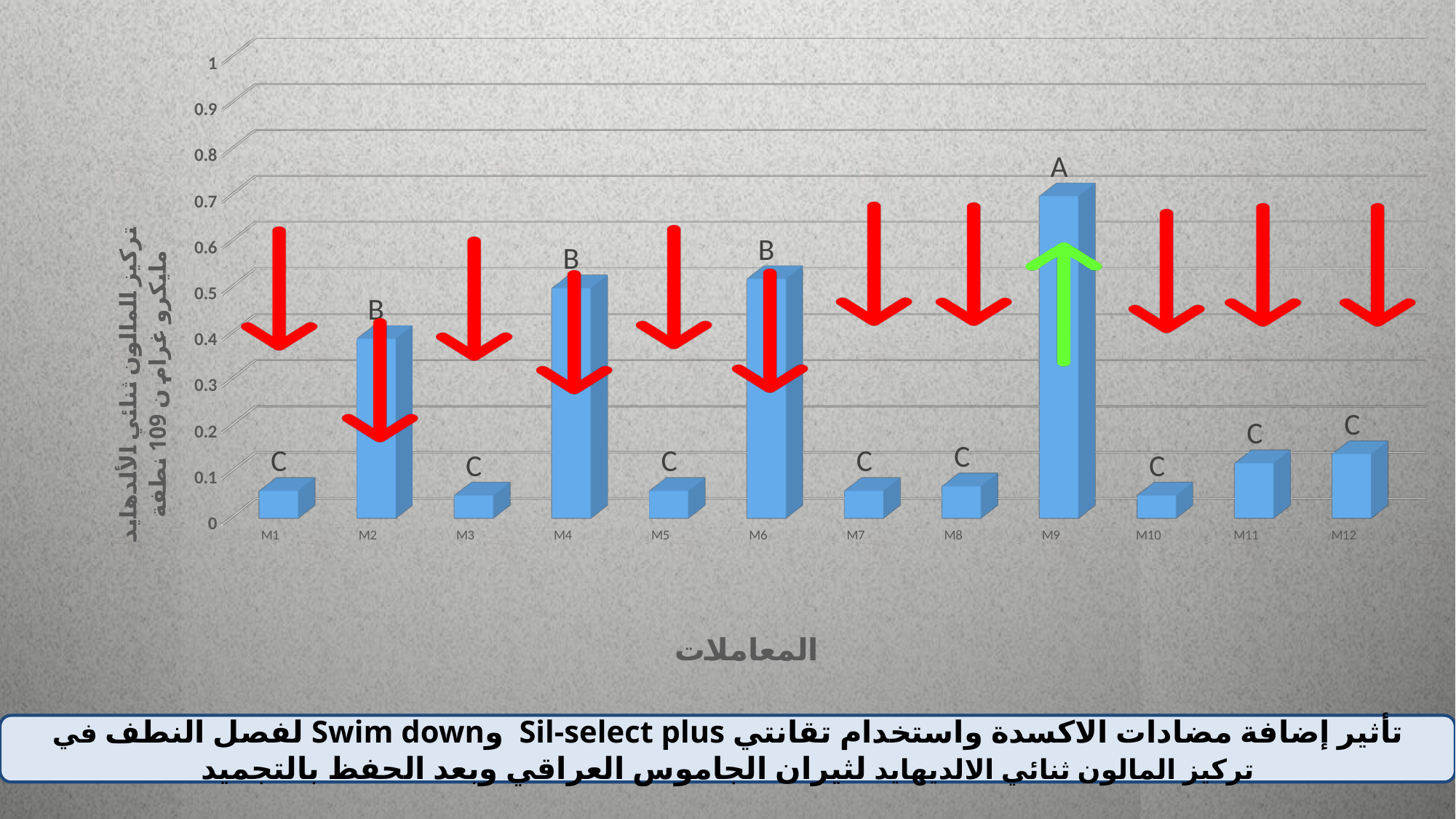
Is the value for M2 greater or less than 0.5? less Is the value for M4 greater or less than 0.4? greater Is the value for M12 greater or less than 0.3? less How many categories are shown on the x axis of the chart? 12 Which letter is printed above the bar for M9? A How many bars in the chart are labelled with the letter B? 3 What kind of chart is shown on the slide? bar chart Which category has the highest bar in the chart? M9 Which is larger, the value for M11 or the value for M1? M11 Which is larger, the value for M9 or the value for M6? M9